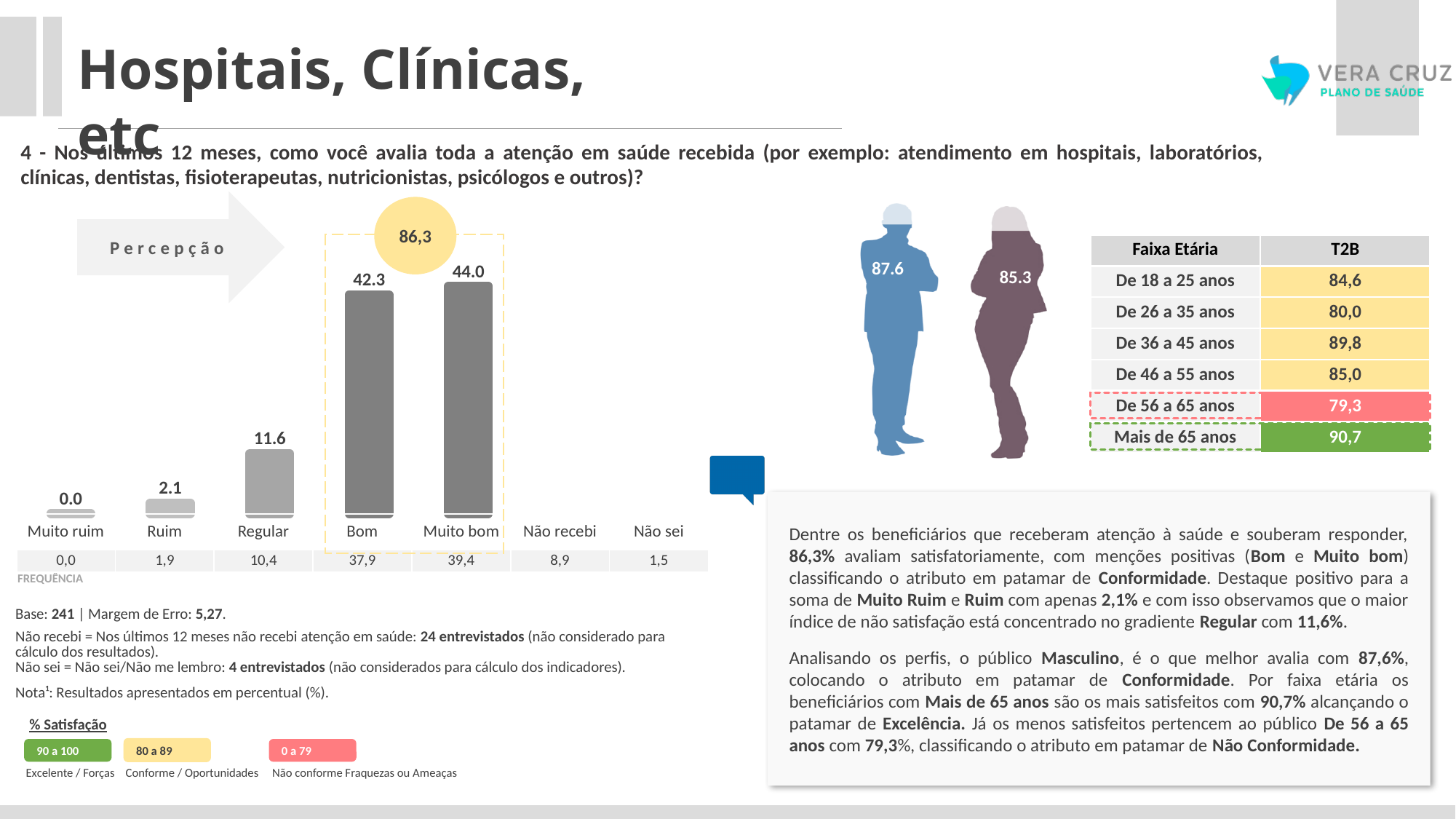
Which category has the lowest value among the plotted bars in the chart? Muito ruim What kind of chart is used to show the evaluation results? Bar chart What value is shown for the Ruim bar in the chart? 2.1 What is the difference between the Muito bom and Bom values in the chart? 1.7 What value is shown for the Regular bar in the chart? 11.6 What is the combined value of Bom and Muito bom highlighted above the chart? 86,3 Which is larger in the chart, the value for Bom or the value for Regular? Bom What value is shown for the Bom bar in the chart? 42.3 What is the difference between the Regular and Ruim values in the chart? 9.5 How many categories are labeled along the x axis of the chart? 7 What value is shown for the Muito bom bar in the chart? 44.0 Which category has the highest bar in the chart? Muito bom